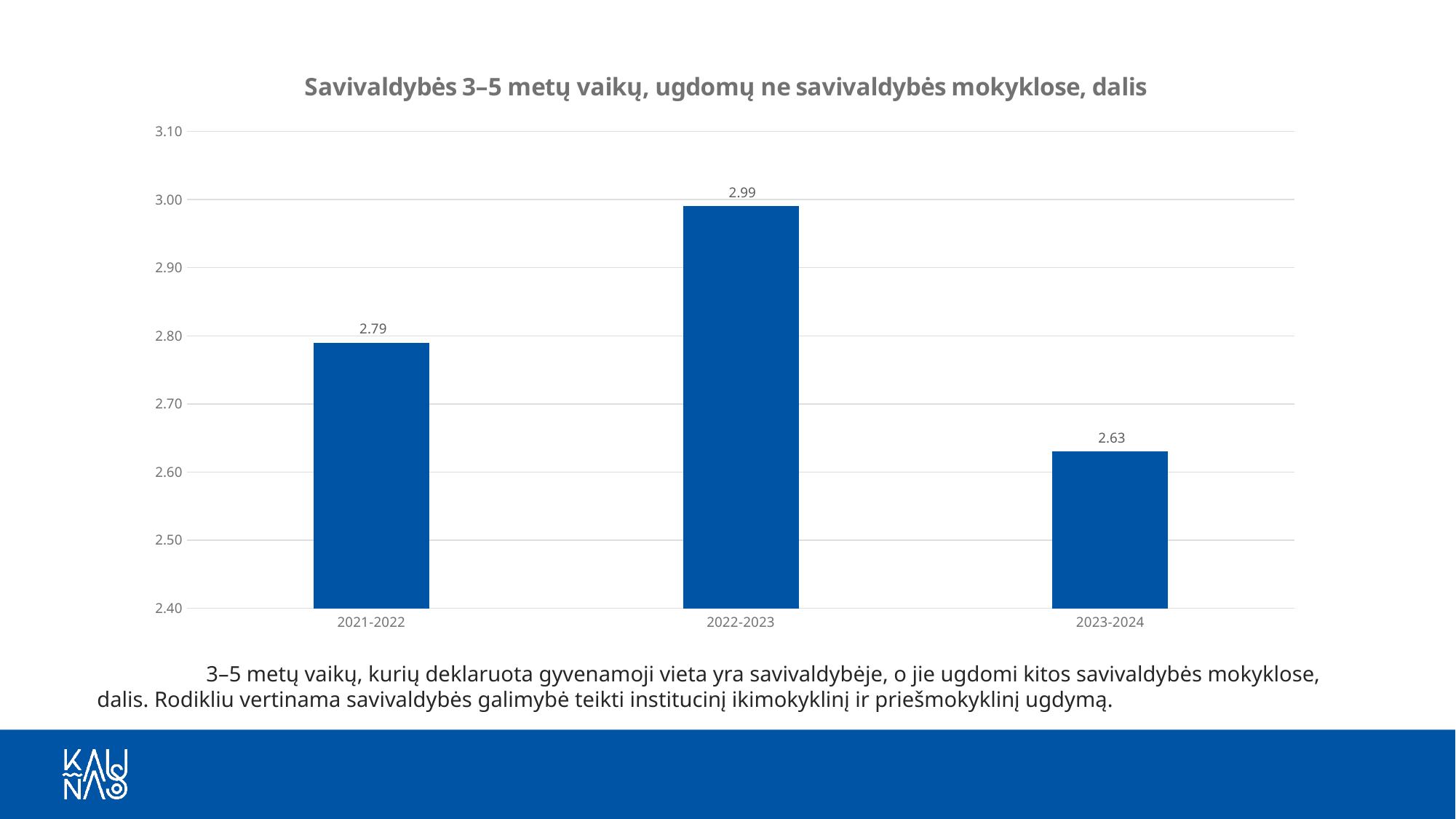
Is the value for 2023-2024 greater or less than 2.70? less Which is larger, the value for 2021-2022 or the value for 2023-2024? 2021-2022 What is the title of the chart? Savivaldybės 3–5 metų vaikų, ugdomų ne savivaldybės mokyklose, dalis How many periods are shown on the x axis? 3 What is the difference between the values for 2022-2023 and 2021-2022? 0.20 What is the value for 2021-2022? 2.79 What is the value for 2022-2023? 2.99 What kind of chart is shown on the slide? bar chart What is the difference between the values for 2022-2023 and 2023-2024? 0.36 Which period has the lowest value? 2023-2024 What is the value for 2023-2024? 2.63 Which period has the highest value? 2022-2023